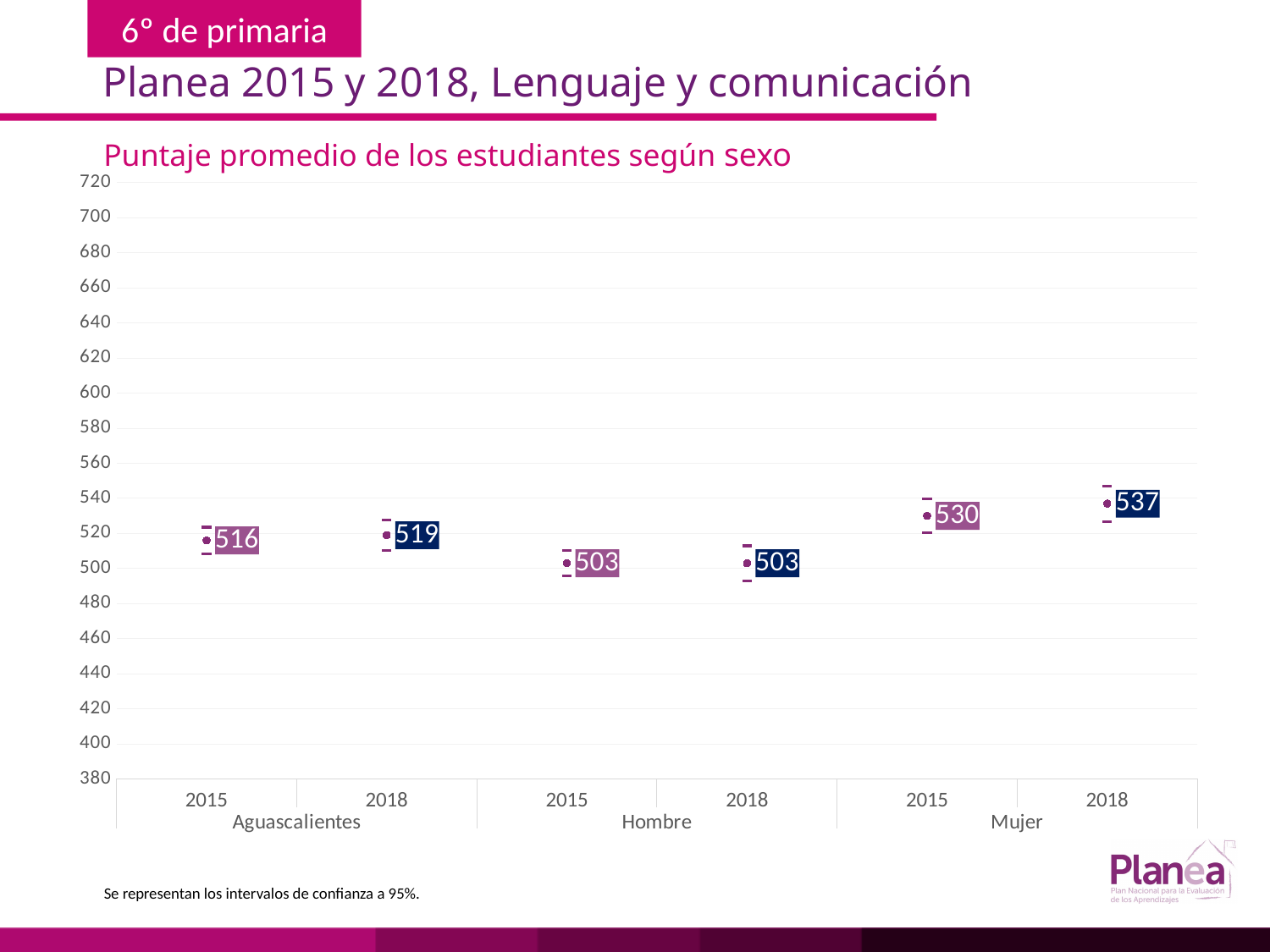
What is the average score for Mujer in 2018? 537 Which group and year has the highest average score? Mujer 2018 What is the highest value shown on the vertical axis? 720 How many data points are plotted on the chart? 6 Which is larger, the Aguascalientes score in 2015 or the Hombre score in 2015? Aguascalientes 2015 What is the title of the chart? Puntaje promedio de los estudiantes según sexo What is the difference between the Mujer and Hombre scores in 2018? 34 What is the average score for Aguascalientes in 2018? 519 Did the Hombre average score change between 2015 and 2018? No, it stayed at 503 What is the difference between the Mujer scores in 2018 and 2015? 7 Did the Aguascalientes average score rise or fall from 2015 to 2018? Rise What is the average score for Hombre in 2015? 503